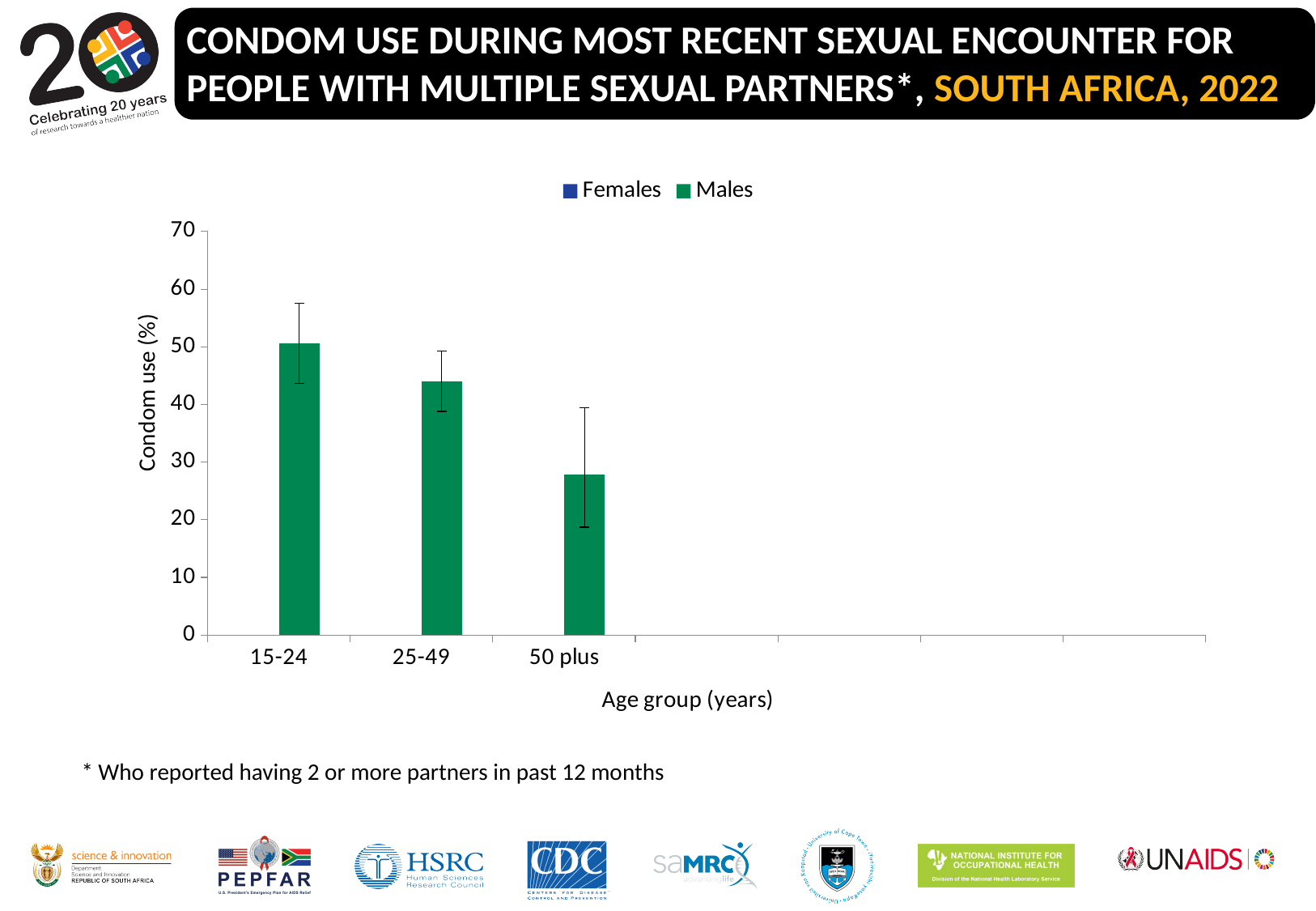
What kind of chart is shown on the slide? Bar chart Is the value for males aged 15-24 greater or less than 40? greater How many age groups have bars plotted on the chart? 3 Is condom use for males higher in the 25-49 age group or the 50 plus age group? 25-49 Is the value for males aged 50 plus greater or less than 40? less Is condom use for males higher in the 15-24 age group or the 25-49 age group? 15-24 Which age group has the highest condom use among males? 15-24 What is the label of the y axis? Condom use (%) Which age group has the lowest condom use among males? 50 plus Is the value for males aged 25-49 greater or less than 50? less Do the values for males rise or fall as age group increases along the x axis? fall How many series does the legend list? 2